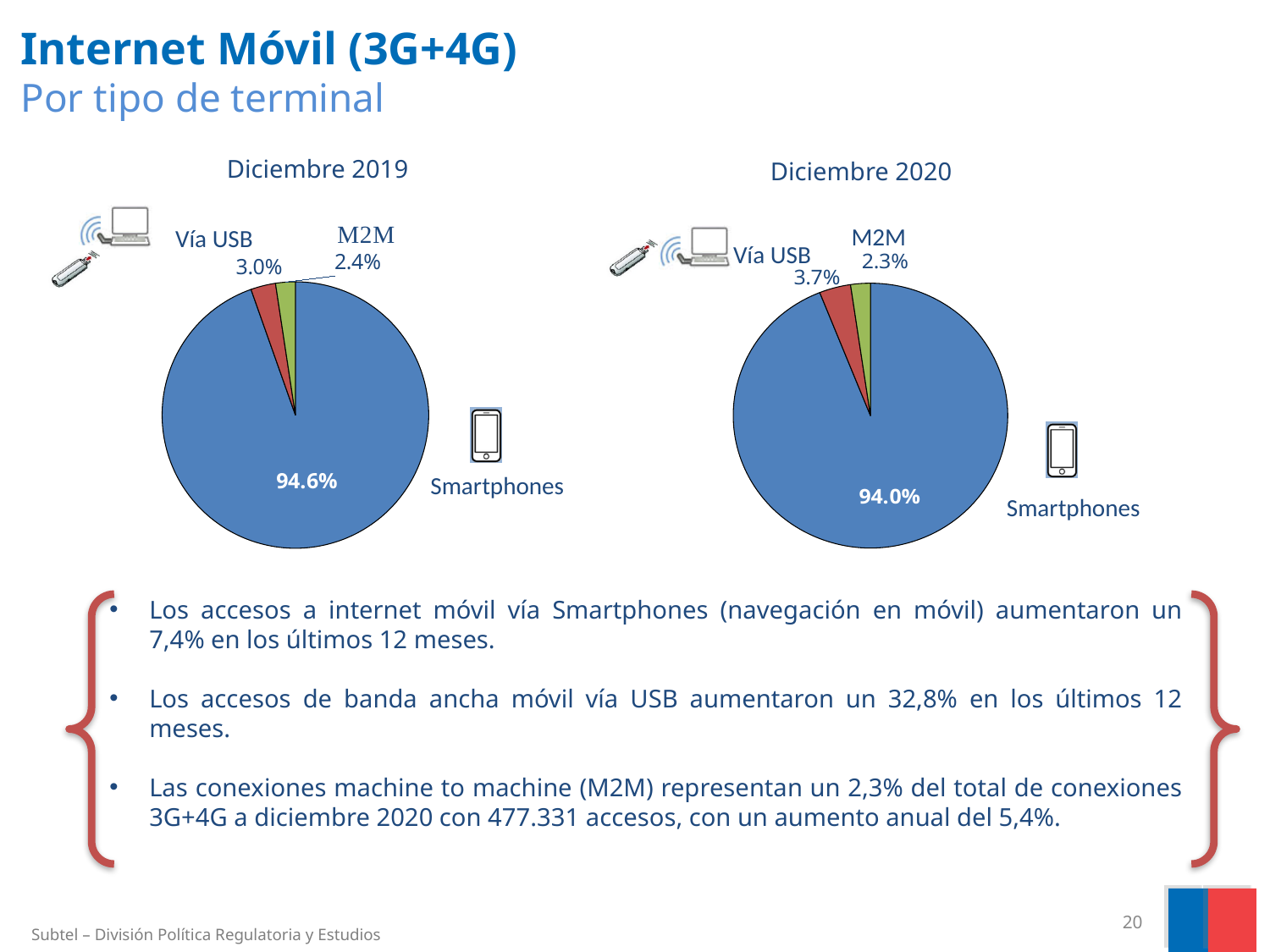
In the Diciembre 2019 pie chart, what is the value for Vía USB? 3.0% In the Diciembre 2020 pie chart, which category has the largest slice? Smartphones In the Diciembre 2019 pie chart, which category has the smallest slice? M2M How many slices does the Diciembre 2020 pie chart have? 3 In the Diciembre 2020 pie chart, what is the value for M2M? 2.3% In the Diciembre 2020 pie chart, what share do Smartphones have? 94.0% What colour is the Smartphones slice in the Diciembre 2020 pie chart? Blue In the Diciembre 2020 pie chart, which is larger, Vía USB or M2M? Vía USB What type of chart is used for Diciembre 2019? Pie chart What is the difference between the Vía USB share in Diciembre 2020 and in Diciembre 2019? 0.7% In the Diciembre 2019 pie chart, what is the difference between the Vía USB and M2M shares? 0.6% In the Diciembre 2019 pie chart, what share do Smartphones have? 94.6%